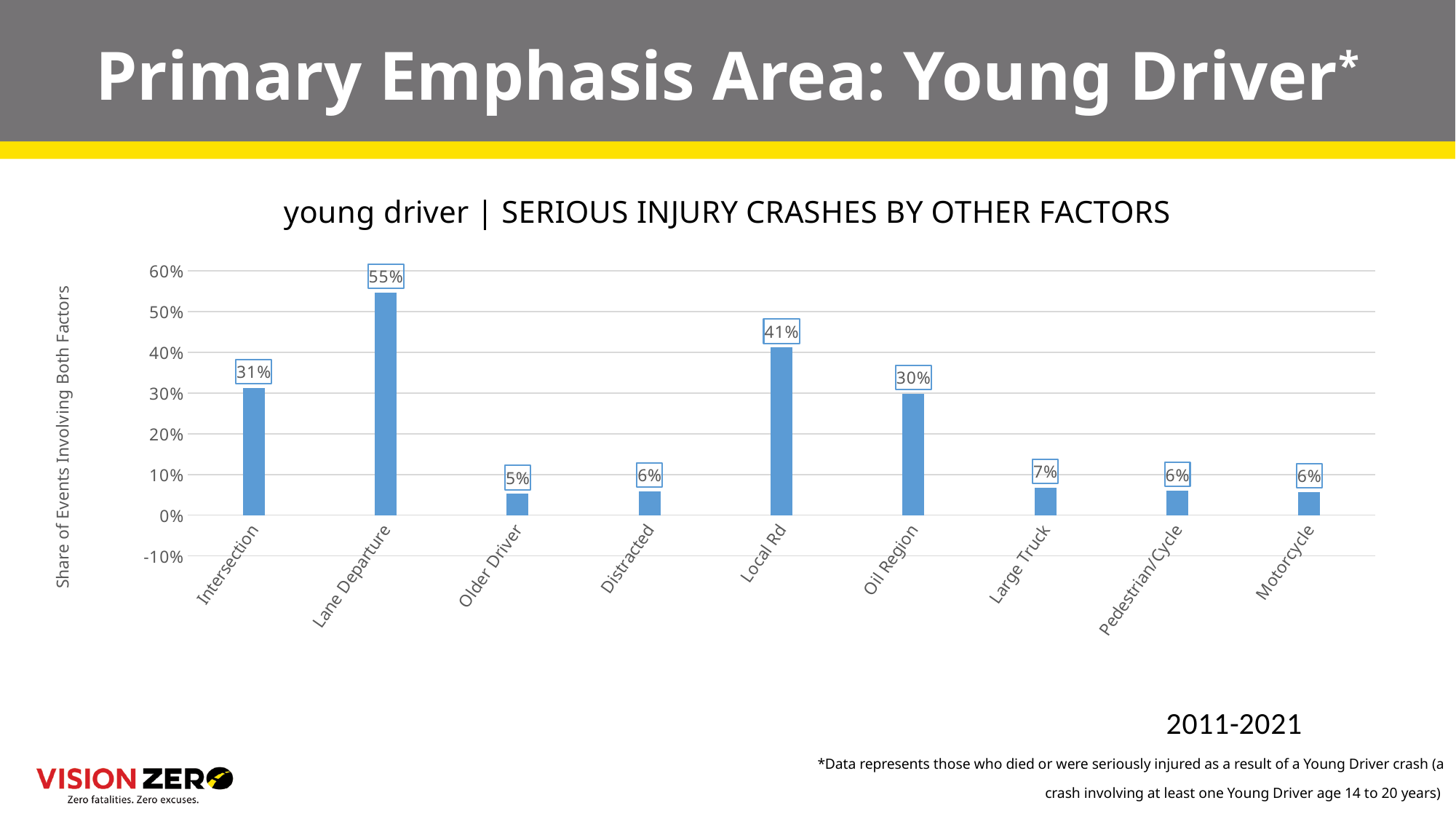
What is the value for Lane Departure? 55% Is the value for Local Rd greater or less than 40%? greater What is the label of the vertical axis? Share of Events Involving Both Factors What is the value for Oil Region? 30% Which is larger, the value for Intersection or the value for Oil Region? Intersection Which category has the lowest value? Older Driver What is the value for Large Truck? 7% What is the value for Local Rd? 41% What is the difference between the values for Lane Departure and Local Rd? 14% What kind of chart is shown on the slide? Bar chart Which category has the highest value? Lane Departure How many categories are shown on the x axis? 9